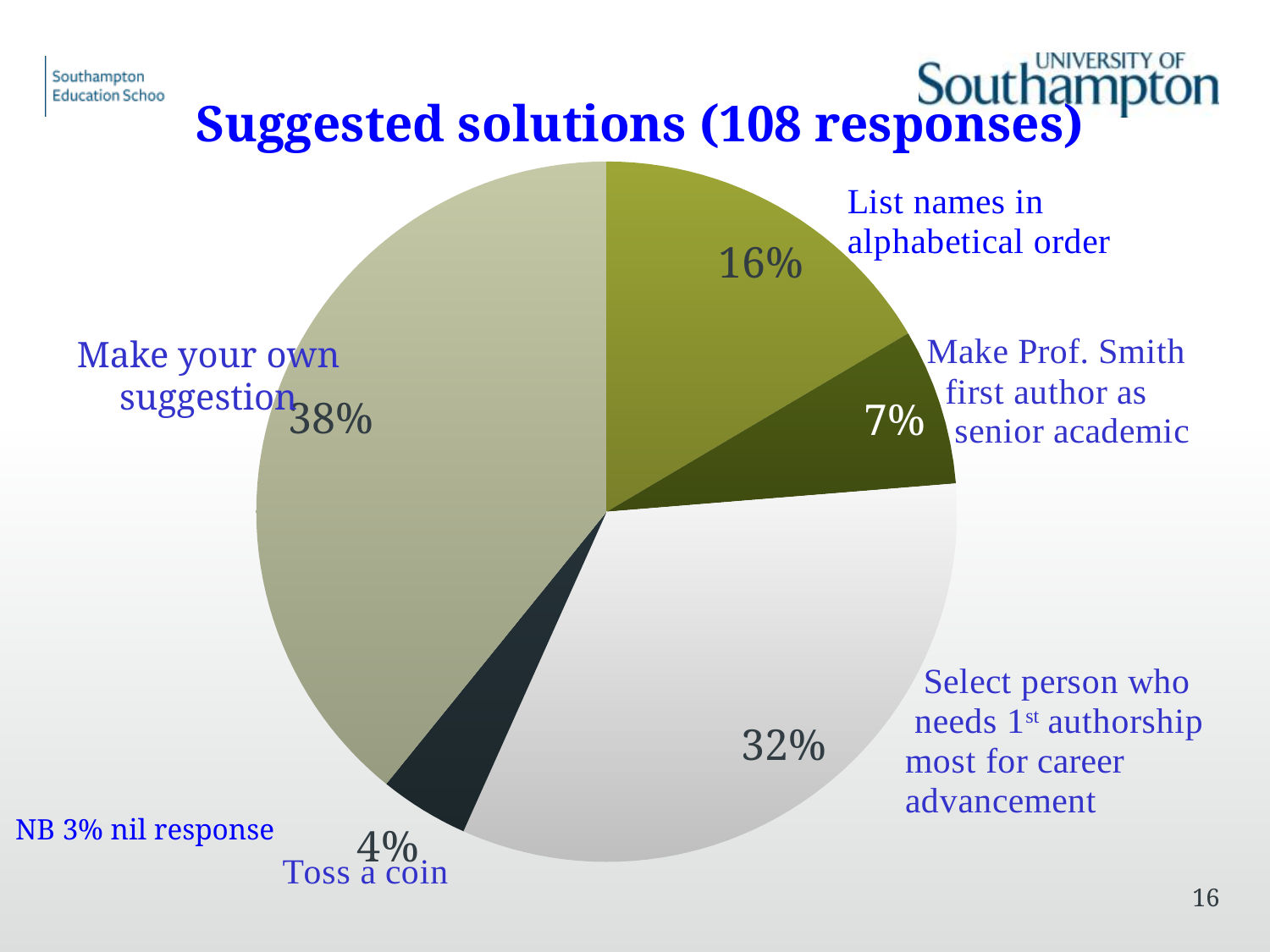
What share of responses is for 'Make Prof. Smith first author as senior academic'? 7% How many slices does the pie chart have? 5 Which suggested solution has the smallest share of responses? Toss a coin Which has a larger share: 'List names in alphabetical order' or 'Make Prof. Smith first author as senior academic'? List names in alphabetical order Which suggested solution has the largest share of responses? Make your own suggestion What share of responses is for 'Make your own suggestion'? 38% What share of responses is for 'Toss a coin'? 4% What is the difference in percentage points between 'Make your own suggestion' and 'Select person who needs 1st authorship most for career advancement'? 6 percentage points What is the title of the chart? Suggested solutions (108 responses) What kind of chart is shown on the slide? Pie chart